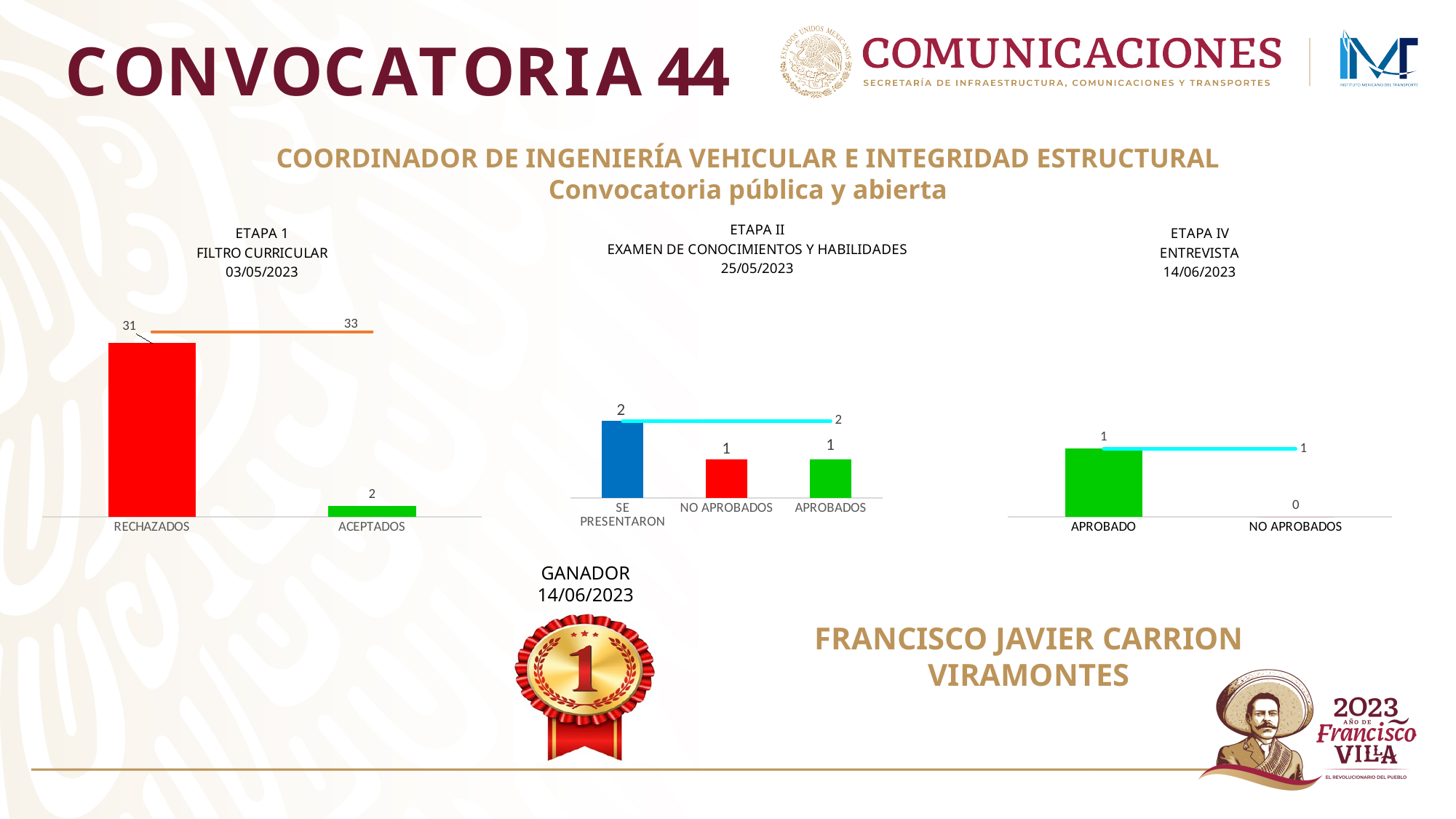
In the ETAPA II EXAMEN DE CONOCIMIENTOS Y HABILIDADES chart, which category has the highest value? SE PRESENTARON In the ETAPA II EXAMEN DE CONOCIMIENTOS Y HABILIDADES chart, what is the value for SE PRESENTARON? 2 In the ETAPA 1 FILTRO CURRICULAR chart, what is the difference between RECHAZADOS and ACEPTADOS? 29 In the ETAPA IV ENTREVISTA chart, what is the value for NO APROBADOS? 0 In the ETAPA IV ENTREVISTA chart, what is the value for APROBADO? 1 In the ETAPA II EXAMEN DE CONOCIMIENTOS Y HABILIDADES chart, what is the value for NO APROBADOS? 1 In the ETAPA II EXAMEN DE CONOCIMIENTOS Y HABILIDADES chart, how many categories are shown on the x axis? 3 In the ETAPA 1 FILTRO CURRICULAR chart, which category has the highest value? RECHAZADOS What kind of chart is the ETAPA IV ENTREVISTA chart? Bar chart In the ETAPA 1 FILTRO CURRICULAR chart, what is the value for RECHAZADOS? 31 In the ETAPA 1 FILTRO CURRICULAR chart, what is the value for ACEPTADOS? 2 In the ETAPA 1 FILTRO CURRICULAR chart, what value is labelled on the orange line? 33